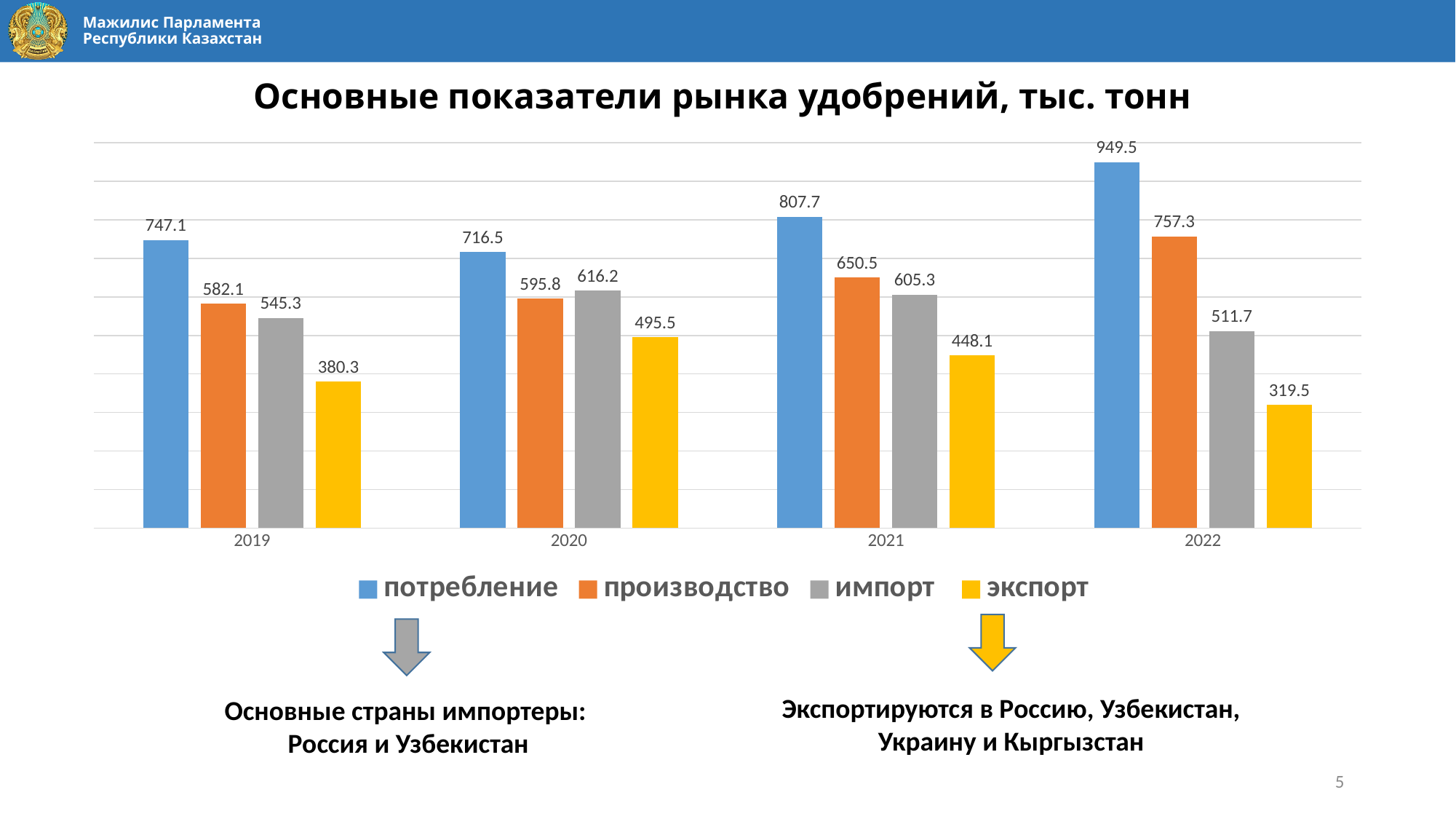
What kind of chart is shown on the slide? bar chart What is the difference between потребление and производство in 2022? 192.2 What is the value for экспорт in 2020? 495.5 In which year is экспорт lowest? 2022 Which is larger in 2020: импорт or производство? импорт What is the value for производство in 2019? 582.1 What is the value for импорт in 2021? 605.3 What is the value for потребление in 2022? 949.5 Does производство rise or fall from 2019 to 2022? rise How many series does the legend list? 4 How many years are shown on the x axis? 4 In which year is потребление highest? 2022